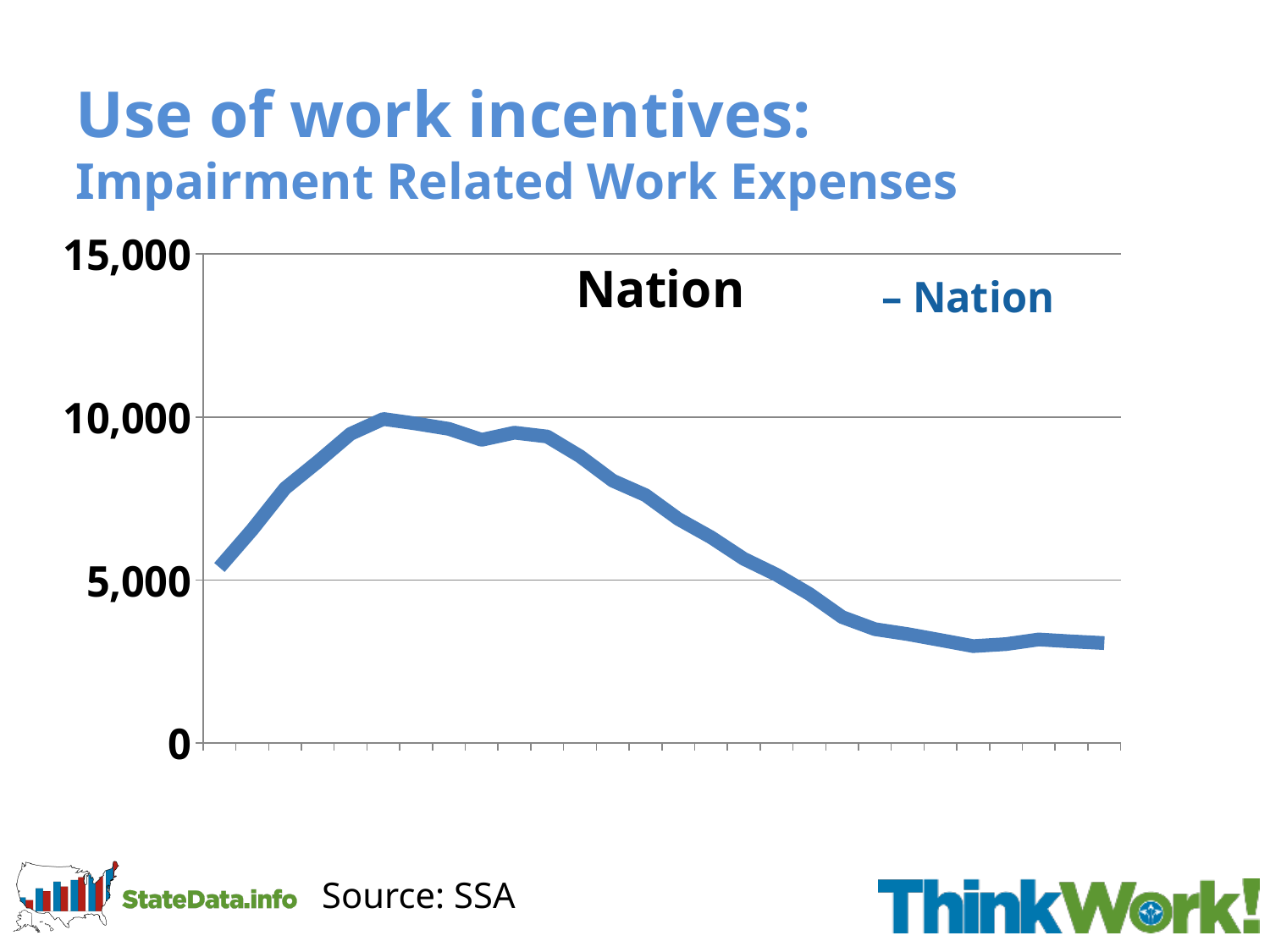
Is the lowest point of the line greater or less than 5,000? less What is the name of the series shown in the chart's legend? Nation What is the highest value labelled on the vertical axis? 15,000 What kind of chart is shown on the slide? line chart Is the value at the left end of the line greater or less than 10,000? less Does the line end higher or lower than where it starts? lower After reaching its peak, does the line rise or fall toward the right end of the x axis? fall How many series does the chart's legend list? 1 Is the value at the right end of the line greater or less than 5,000? less What is the title printed inside the chart area? Nation